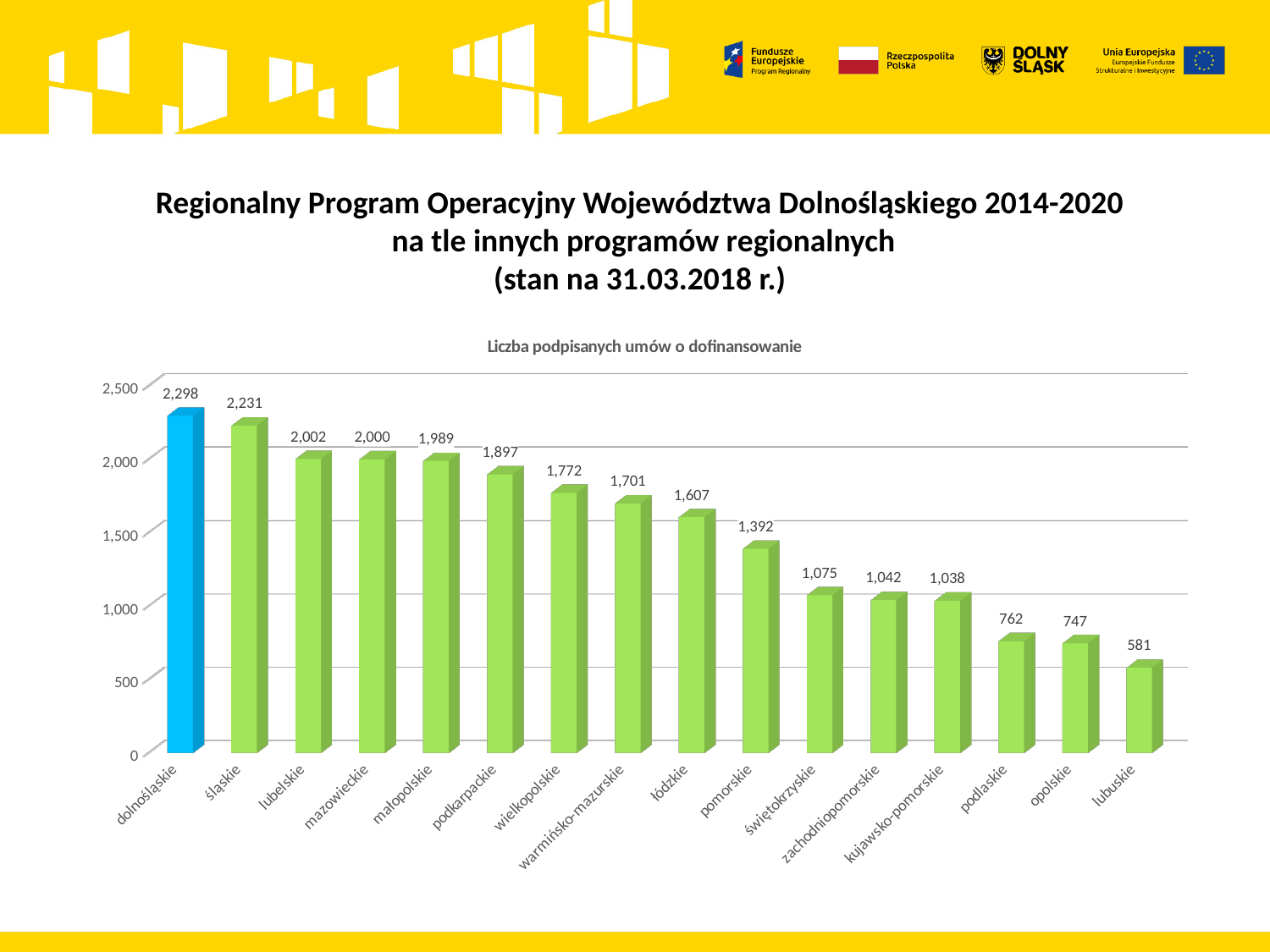
Which category has the lowest value? lubuskie What is the difference between the values for dolnośląskie and śląskie? 67 Which is larger, the value for łódzkie or the value for pomorskie? łódzkie How many categories are shown on the x axis? 16 What is the value for dolnośląskie? 2,298 What is the value for pomorskie? 1,392 Do the values rise or fall from left to right along the x axis? fall Which category has the highest value? dolnośląskie What kind of chart is shown? bar chart What is the title of the chart? Liczba podpisanych umów o dofinansowanie Is the value for podlaskie greater or less than 1,000? less What is the value for lubuskie? 581